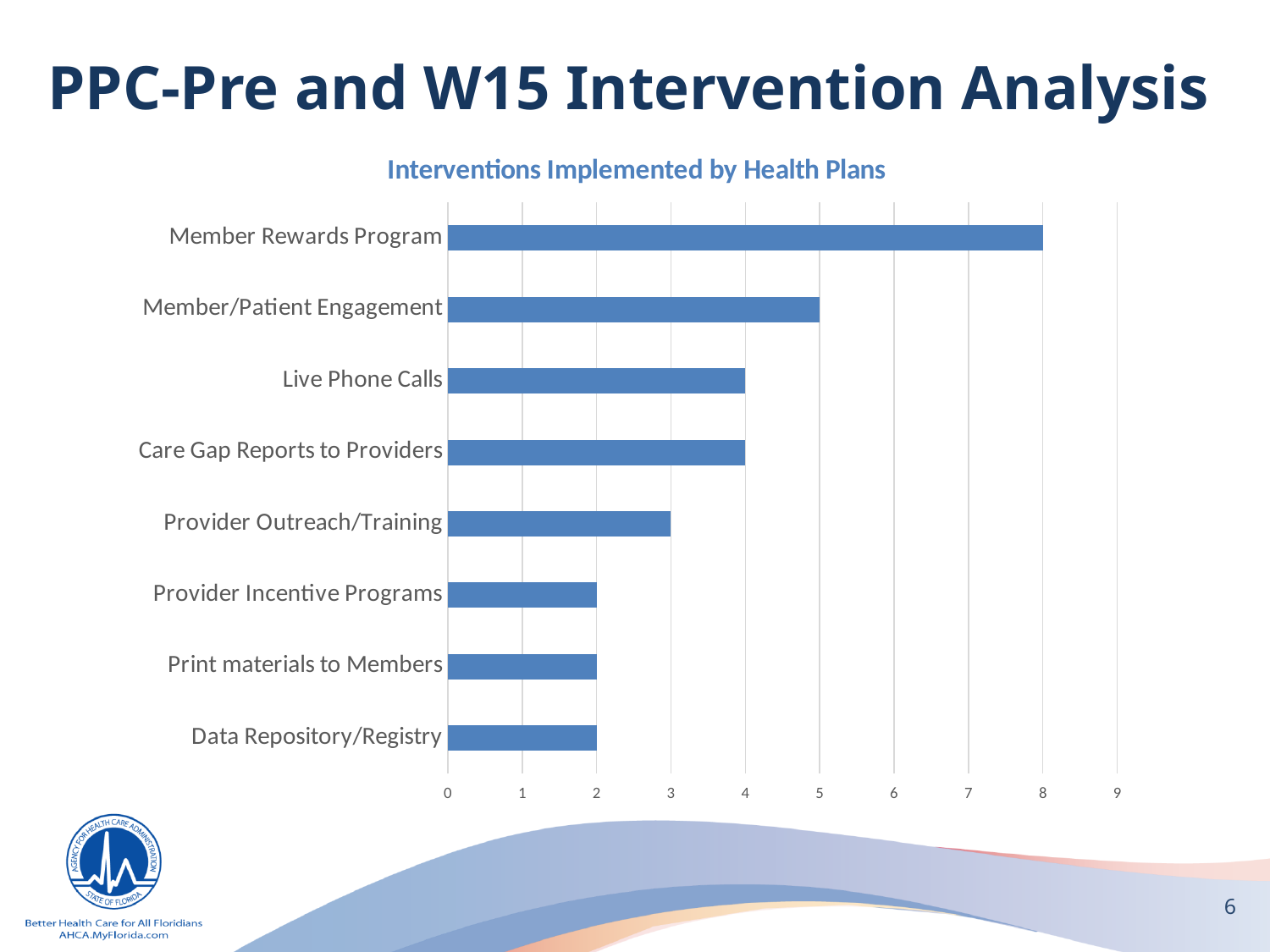
What is the difference between the values for Care Gap Reports to Providers and Data Repository/Registry? 2 What is the value for Live Phone Calls? 4 Which is larger, the value for Live Phone Calls or the value for Provider Incentive Programs? Live Phone Calls What is the title of the chart? Interventions Implemented by Health Plans How many interventions are shown in the chart? 8 What is the value for Member/Patient Engagement? 5 Which intervention has the highest value? Member Rewards Program What is the value for Provider Outreach/Training? 3 What is the value for Member Rewards Program? 8 Is the value for Member Rewards Program greater or less than 6? greater What is the difference between the values for Member Rewards Program and Member/Patient Engagement? 3 What kind of chart is shown on the slide? Bar chart